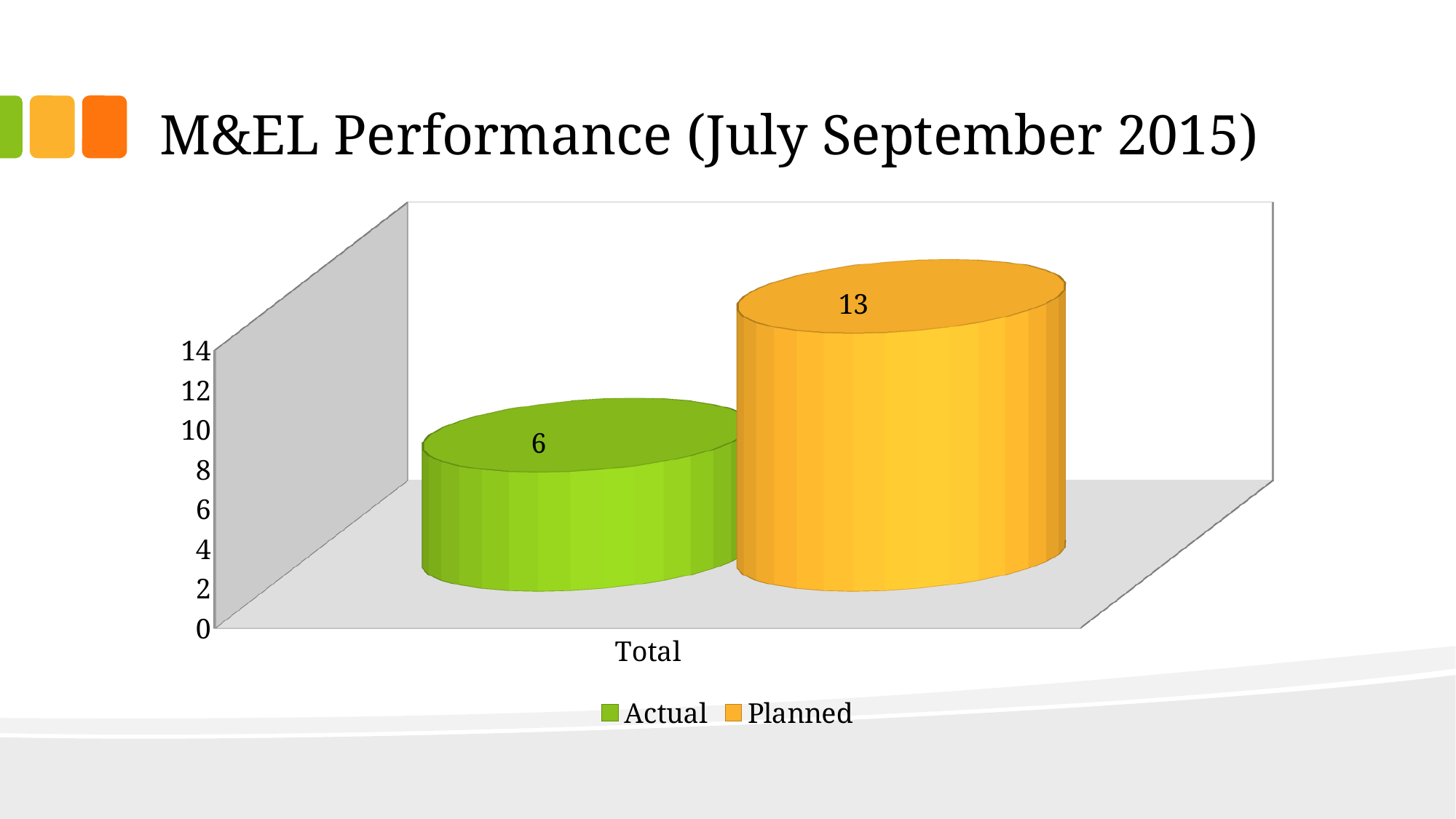
What kind of chart is shown on the slide? Bar chart Which series has the higher value for Total, Actual or Planned? Planned What is the difference between the Planned and Actual values for Total? 7 What colour represents the Planned series? Orange What is the title of the slide? M&EL Performance (July September 2015) Which series has the lowest value on the chart? Actual How many series does the legend list? 2 Is the Actual value for Total greater or less than 8? less What is the Planned value for Total? 13 How many categories are shown on the x axis? 1 Is the Planned value for Total greater or less than 10? greater What is the Actual value for Total? 6